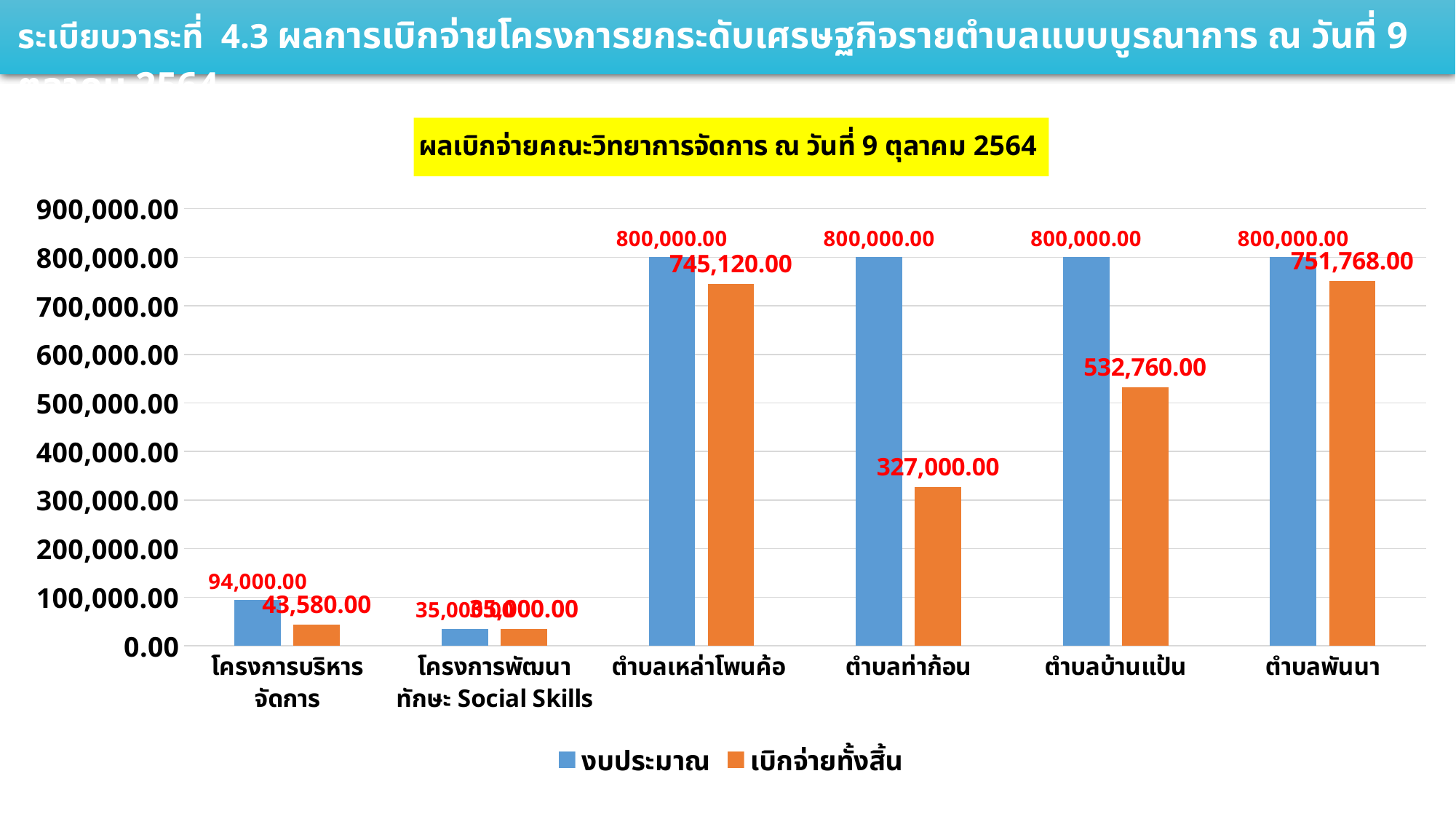
What is the เบิกจ่ายทั้งสิ้น value for ตำบลพันนา? 751,768.00 What is the เบิกจ่ายทั้งสิ้น value for ตำบลบ้านแป้น? 532,760.00 What is the งบประมาณ value for โครงการบริหารจัดการ? 94,000.00 Is the เบิกจ่ายทั้งสิ้น value for ตำบลเหล่าโพนค้อ greater or less than 700,000.00? greater Which is larger: the เบิกจ่ายทั้งสิ้น value for ตำบลบ้านแป้น or for ตำบลท่าก้อน? ตำบลบ้านแป้น What is the difference between งบประมาณ and เบิกจ่ายทั้งสิ้น for ตำบลเหล่าโพนค้อ? 54,880.00 Which category has the lowest งบประมาณ value? โครงการพัฒนาทักษะ Social Skills What kind of chart is shown on the slide? bar chart Which category has the highest เบิกจ่ายทั้งสิ้น value? ตำบลพันนา How many series does the legend list? 2 How many categories are shown on the x axis? 6 What is the เบิกจ่ายทั้งสิ้น value for ตำบลท่าก้อน? 327,000.00